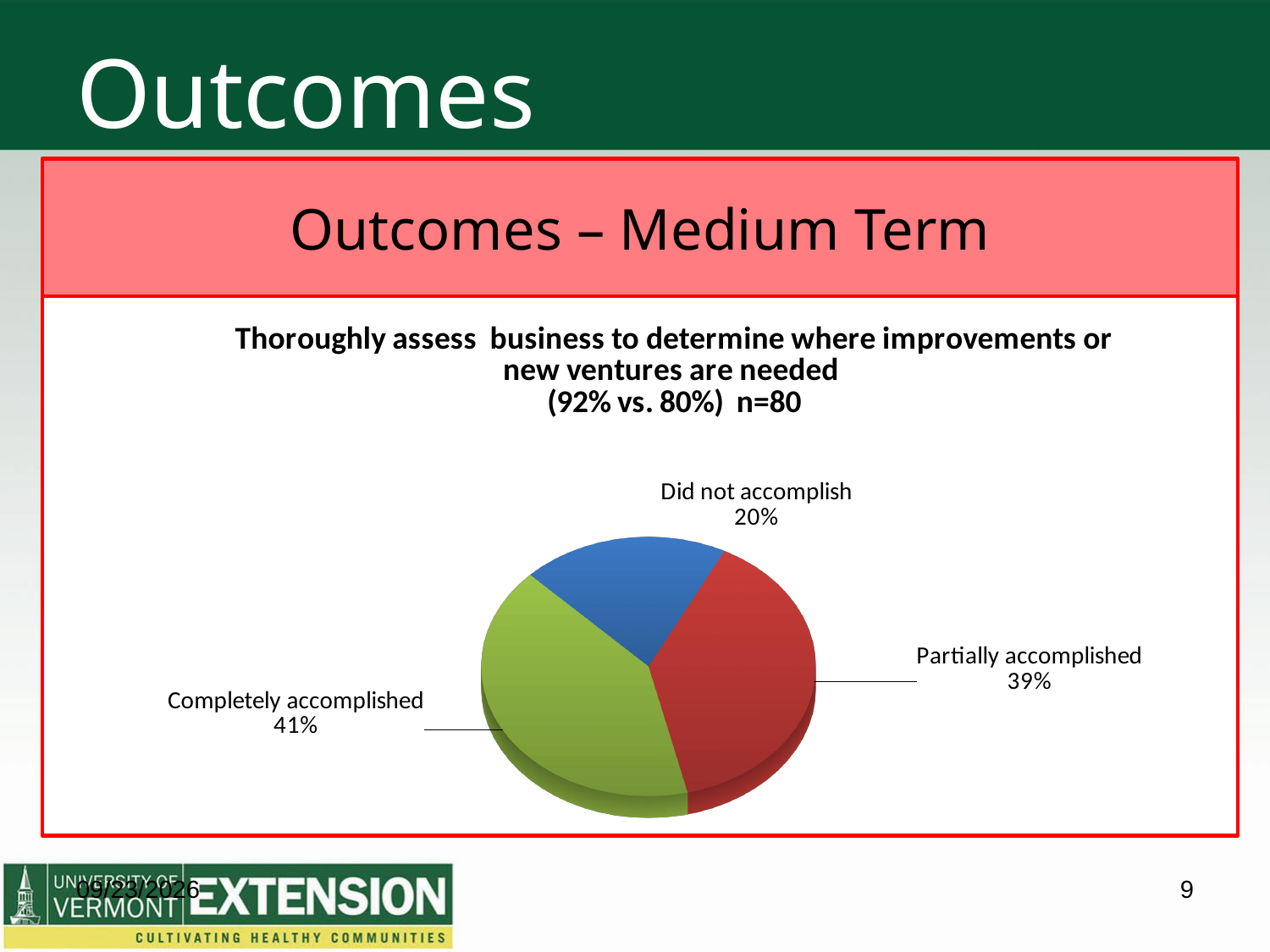
What is the difference in percentage points between the "Completely accomplished" and "Did not accomplish" slices? 21 What kind of chart is shown on the slide? pie chart What colour is the "Did not accomplish" slice? blue Which is larger, the "Partially accomplished" slice or the "Did not accomplish" slice? Partially accomplished Which slice of the pie is the largest? Completely accomplished Which slice of the pie is the smallest? Did not accomplish How many slices does the pie chart have? 3 What is the difference in percentage points between the "Completely accomplished" and "Partially accomplished" slices? 2 What share of the pie is labelled "Partially accomplished"? 39% What is the sample size (n) stated in the chart title? n=80 What share of the pie is labelled "Did not accomplish"? 20% What share of the pie is labelled "Completely accomplished"? 41%